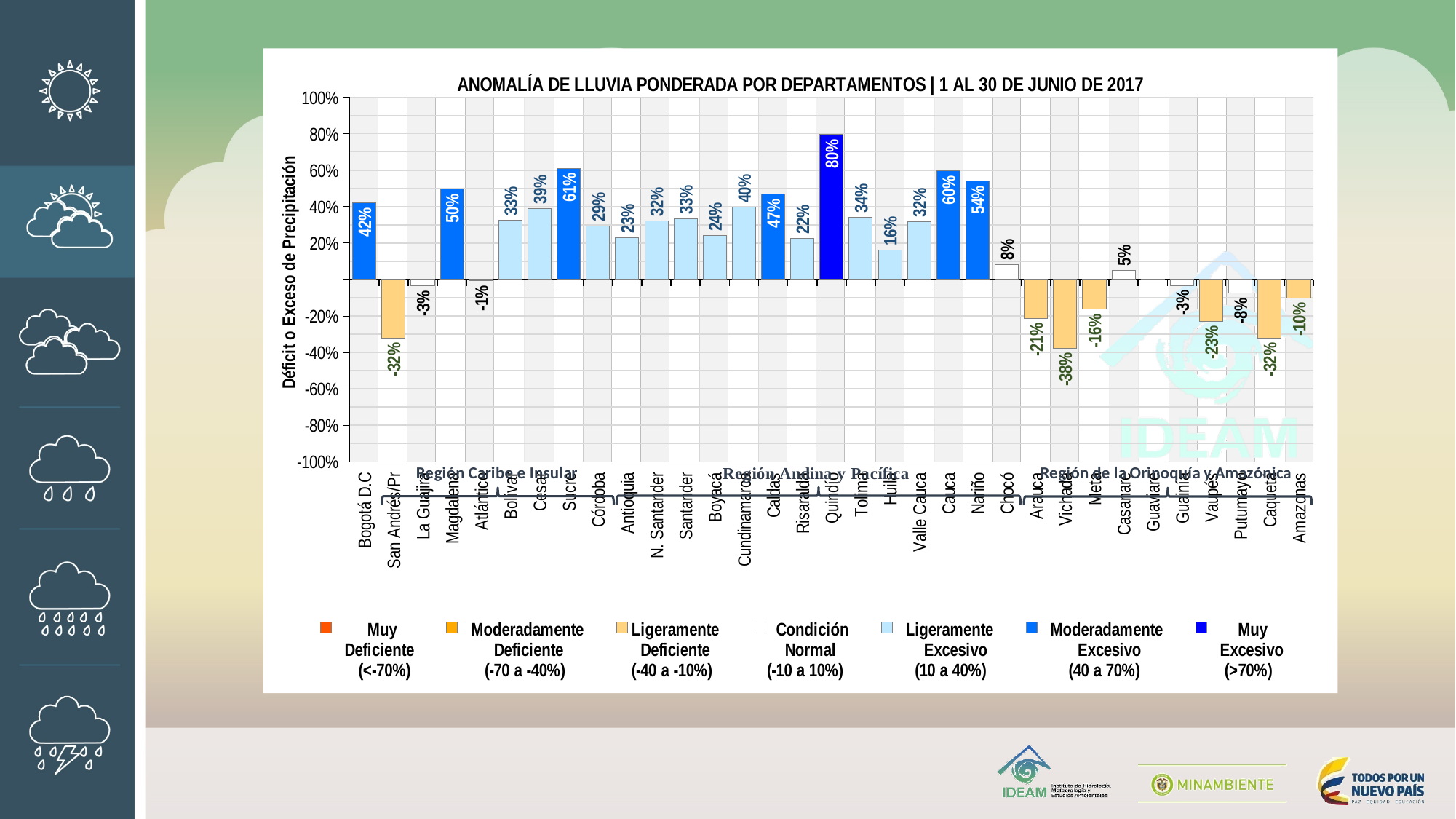
What is the value for Quindío? 80% How many departments are shown on the x axis? 33 What is the value for Vichada? -38% What is the value for Bogotá D.C? 42% What is the title of the chart? ANOMALÍA DE LLUVIA PONDERADA POR DEPARTAMENTOS | 1 AL 30 DE JUNIO DE 2017 Which is larger, the value for Sucre or the value for Nariño? Sucre What is the difference between the values for Quindío and Magdalena? 30 percentage points How many categories does the legend list? 7 What kind of chart is this? Bar chart Which department has the highest value? Quindío Which department has the lowest value? Vichada What is the value for Casanare? 5%